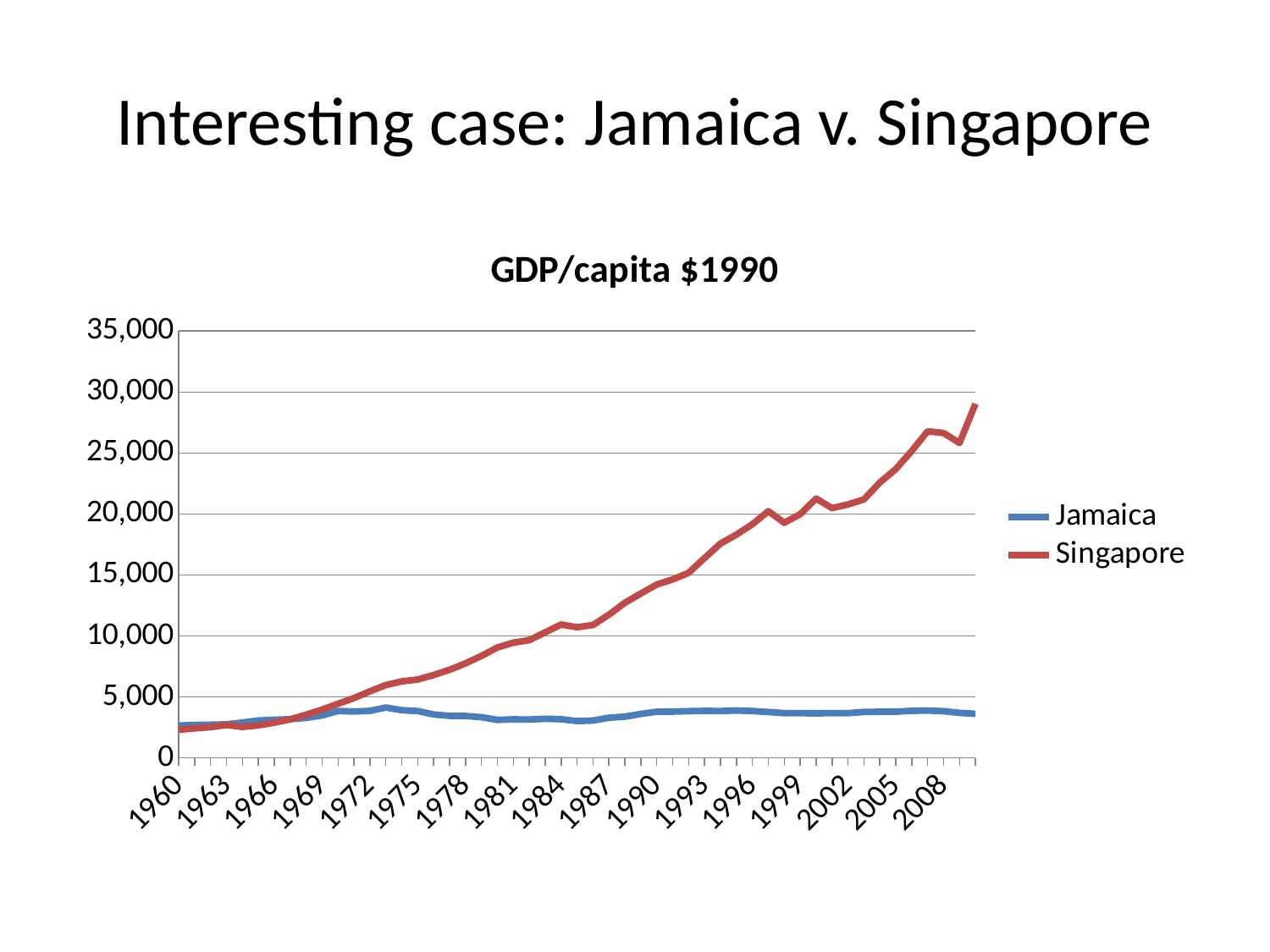
Is the value for Singapore in 2008 greater or less than 25,000? greater What kind of chart is shown on the slide? line chart How many series does the legend list? 2 What is the title of the chart? GDP/capita $1990 Does the Singapore line rise or fall from 1960 to the end of the series? rise Is the value for Singapore in 1975 greater or less than 5,000? greater Is the value for Singapore in 1987 greater or less than 10,000? greater In 2008, which series has the higher value, Jamaica or Singapore? Singapore How many year labels are shown on the x axis? 17 Which series is drawn in red? Singapore